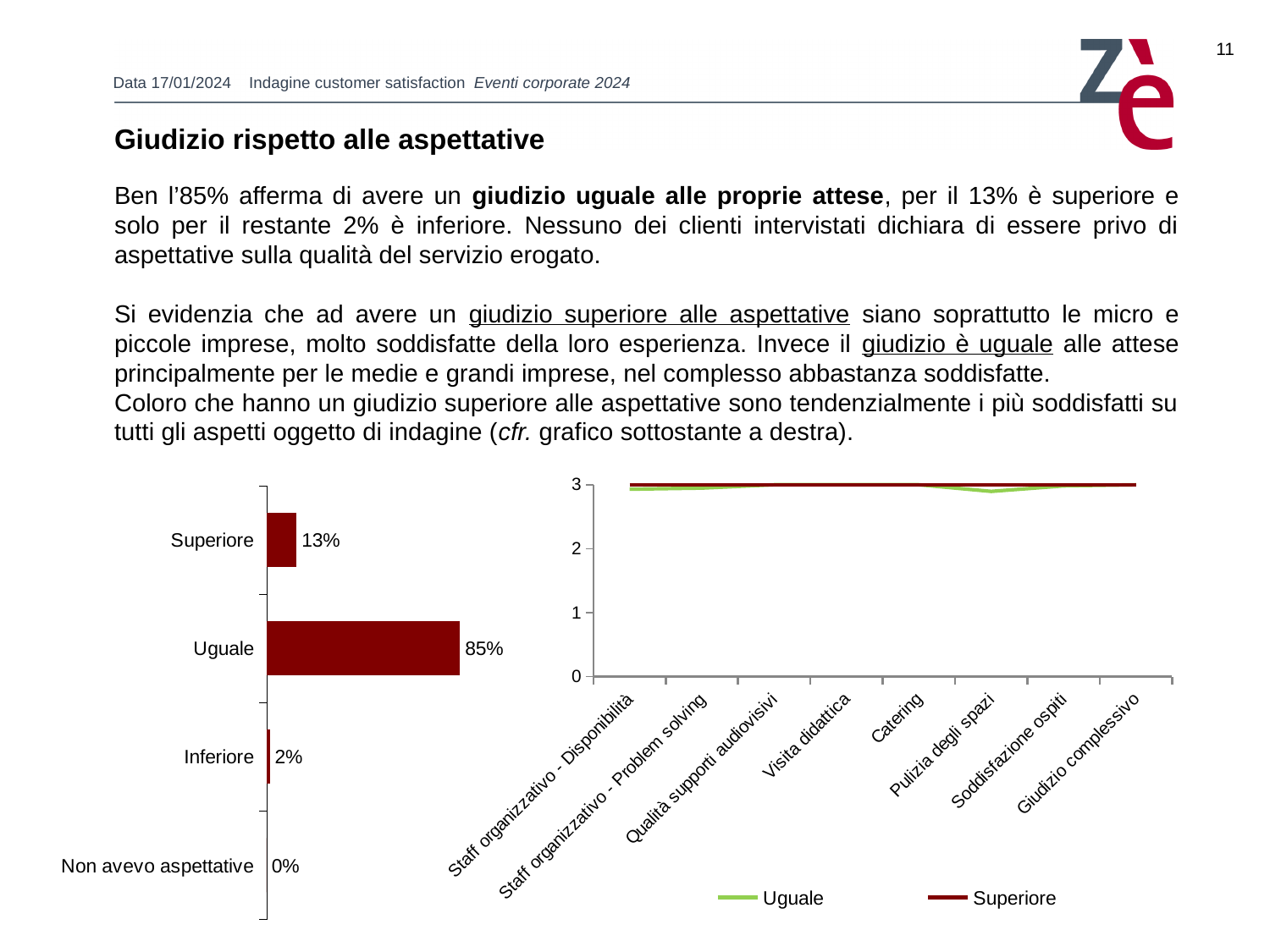
In the bar chart on the left, what is the value for 'Non avevo aspettative'? 0% In the bar chart on the left, what percentage of respondents gave a judgement 'Uguale' to their expectations? 85% In the bar chart on the left, which is larger: the value for 'Superiore' or the value for 'Inferiore'? Superiore How many series does the legend of the line chart on the right list? 2 What kind of chart is the chart on the left of the slide? Bar chart In the bar chart on the left, what is the value for 'Superiore'? 13% In the bar chart on the left, what is the value for 'Inferiore'? 2% In the bar chart on the left, which category has the lowest value? Non avevo aspettative How many categories are shown in the bar chart on the left? 4 In the bar chart on the left, which category has the highest value? Uguale In the bar chart on the left, what is the difference between the values for 'Uguale' and 'Superiore'? 72% In the line chart on the right, is the value of the 'Superiore' series for 'Catering' greater or less than 2? greater